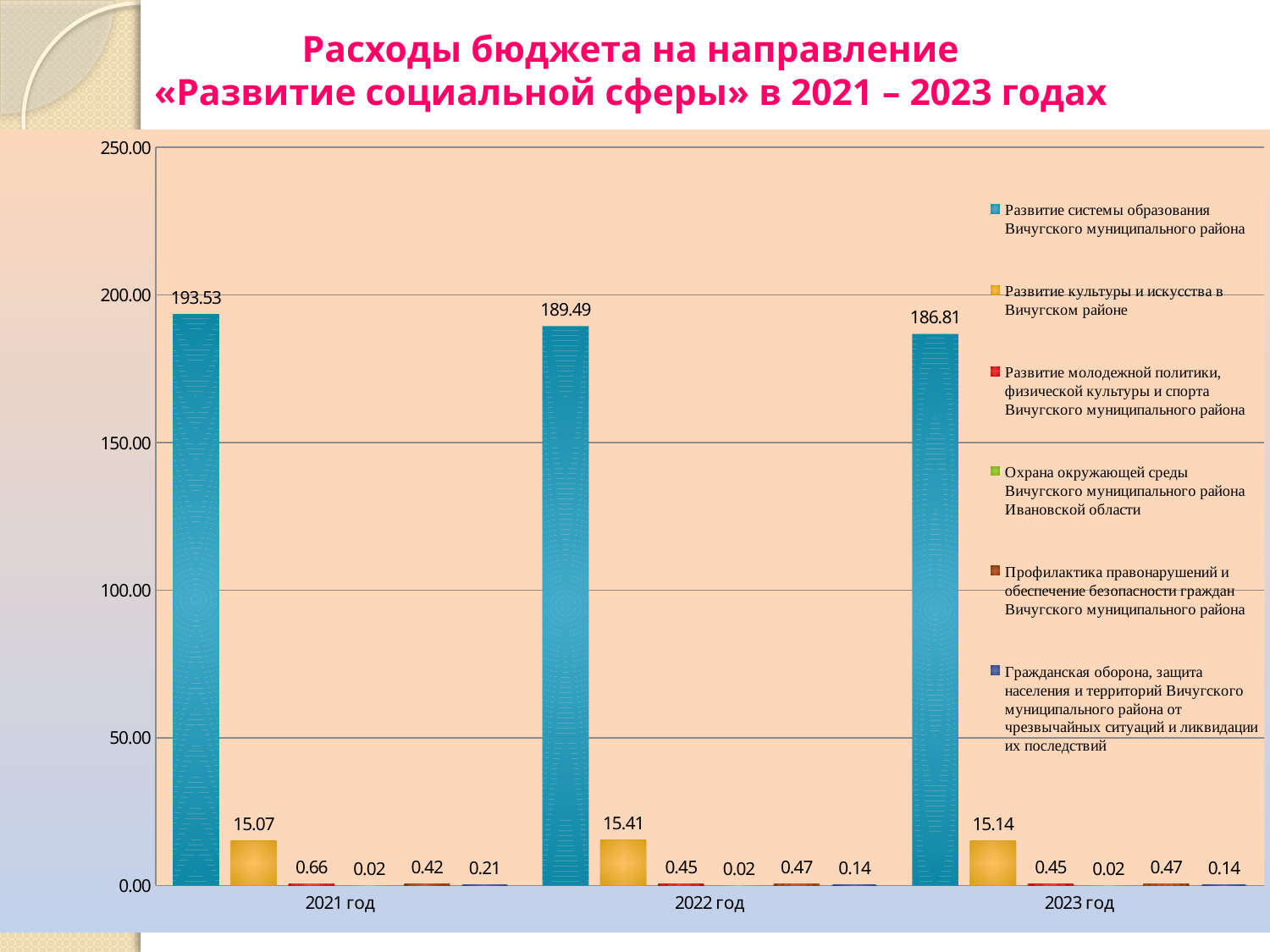
What is the difference between the «Развитие системы образования» values in 2021 год and 2023 год? 6.72 What is the value for «Гражданская оборона...» in 2023 год? 0.14 What is the value for «Развитие культуры и искусства в Вичугском районе» in 2022 год? 15.41 Is the value for «Развитие системы образования» in 2022 год greater or less than 200.00? less In which year is the value for «Развитие системы образования» the lowest? 2023 год How many year categories are shown on the x axis? 3 What is the value for «Развитие молодежной политики, физической культуры и спорта» in 2021 год? 0.66 What is the value for «Развитие системы образования Вичугского муниципального района» in 2021 год? 193.53 Does the value for «Развитие системы образования» rise or fall from 2021 to 2023? fall In which year is the value for «Развитие системы образования» the highest? 2021 год What type of chart is shown on the slide? bar chart How many series does the legend list? 6